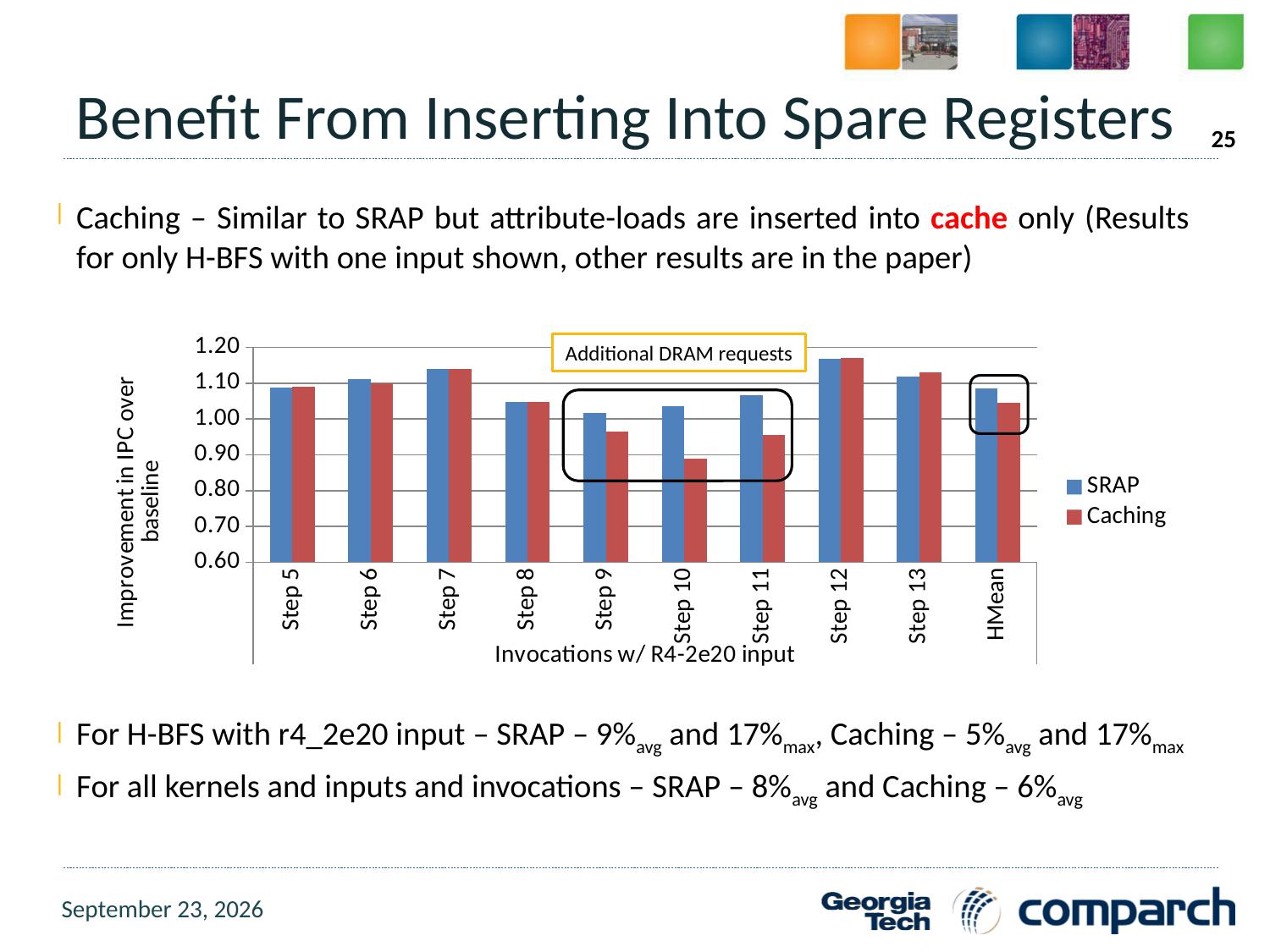
For HMean, which is larger: the SRAP value or the Caching value? SRAP Is the Caching value for Step 9 greater or less than 1.00? less Which category has the lowest Caching value? Step 10 For Step 10, which is larger: the SRAP value or the Caching value? SRAP What kind of chart is shown on the slide? bar chart How many categories are shown along the x axis of the chart? 10 How many series does the chart legend list? 2 Which category has the highest SRAP value? Step 12 Is the SRAP value for Step 12 greater or less than 1.10? greater What text is in the annotation box above the chart's highlighted bars? Additional DRAM requests Is the SRAP value for Step 11 greater or less than 1.00? greater